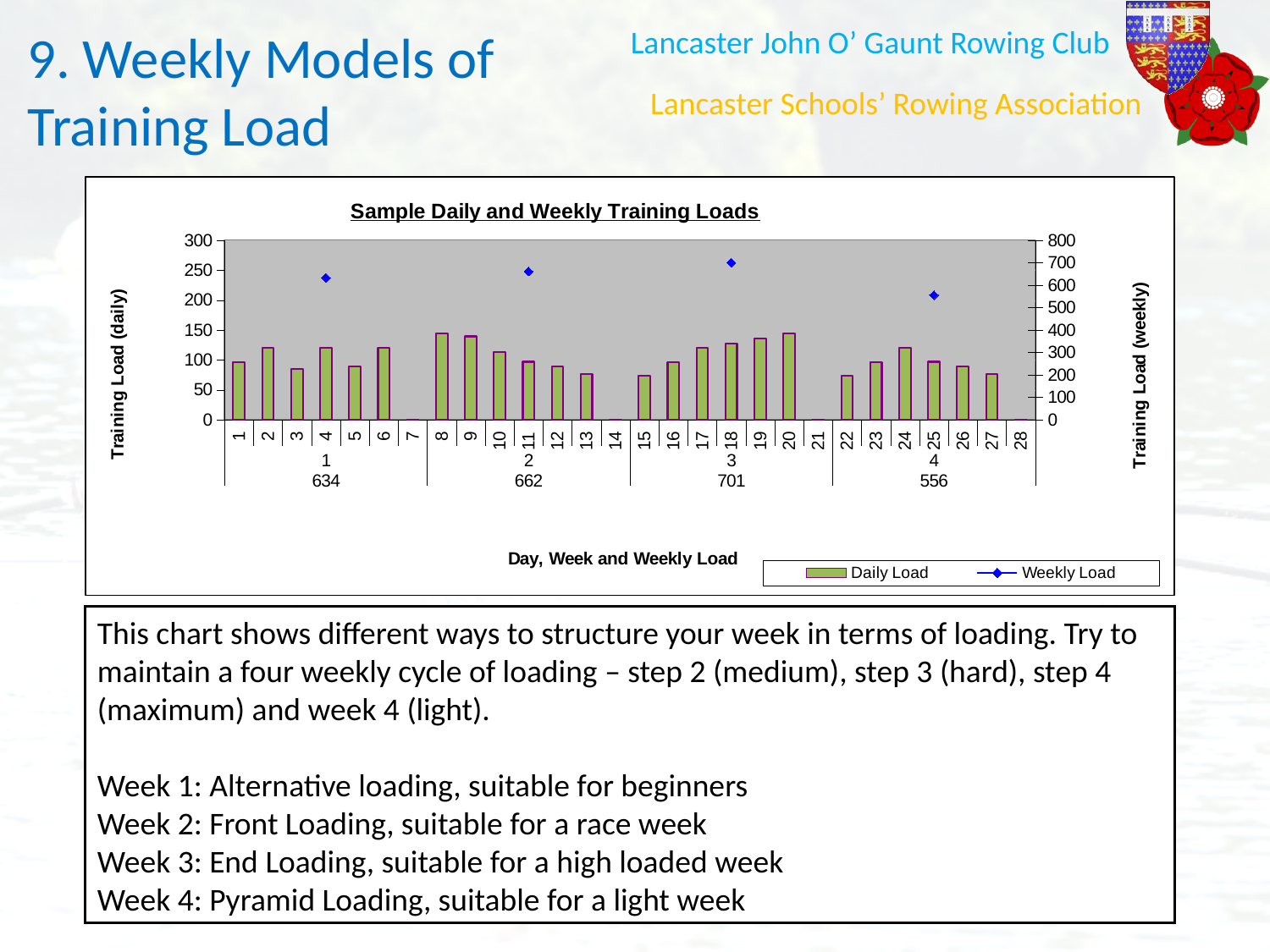
Do the daily loads rise or fall from day 15 to day 20? Rise What is the weekly load shown for week 3? 701 Is the daily load for day 8 greater or less than 100? greater How many series does the chart legend list? 2 What kind of chart is used for the Daily Load series? Bar chart Which week has the lowest weekly load? Week 4 What is the weekly load shown for week 1? 634 How many days are plotted along the x axis? 28 Which has the larger weekly load, week 1 or week 2? Week 2 What is the difference between the weekly loads of week 3 and week 4? 145 Which week has the highest weekly load? Week 3 What is the title of the chart? Sample Daily and Weekly Training Loads